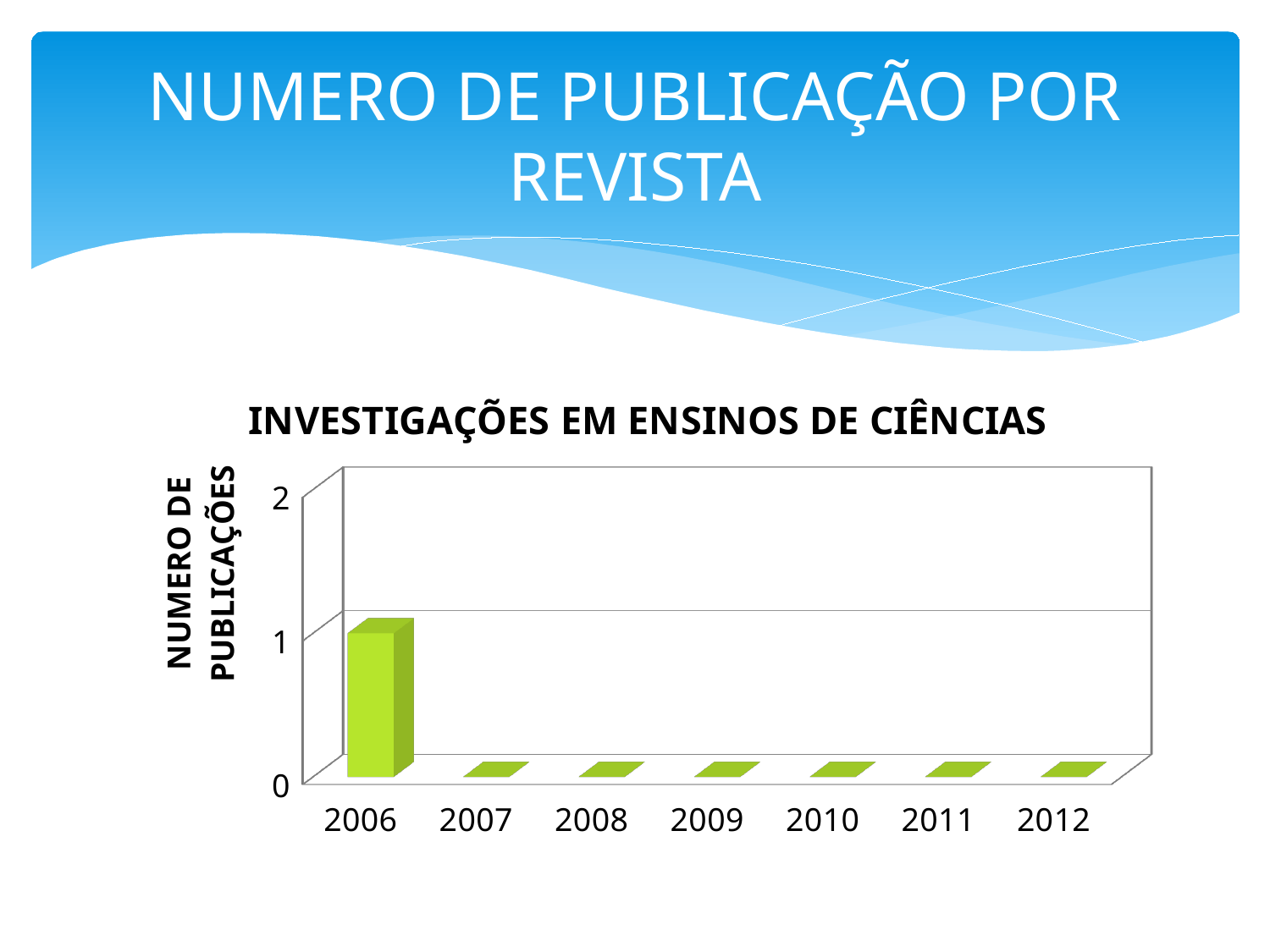
Is the value for 2006 greater or less than 2? less What is the label of the vertical axis? NUMERO DE PUBLICAÇÕES Which year has the highest number of publications? 2006 What is the number of publications for 2010? 0 What is the difference between the number of publications in 2006 and in 2007? 1 Does the number of publications rise or fall from 2006 to 2007? fall Which year has more publications, 2006 or 2012? 2006 What is the total number of publications across all years shown? 1 What kind of chart is shown on the slide? bar chart What is the title of the chart? INVESTIGAÇÕES EM ENSINOS DE CIÊNCIAS How many years are shown on the x axis? 7 What is the number of publications for 2006? 1